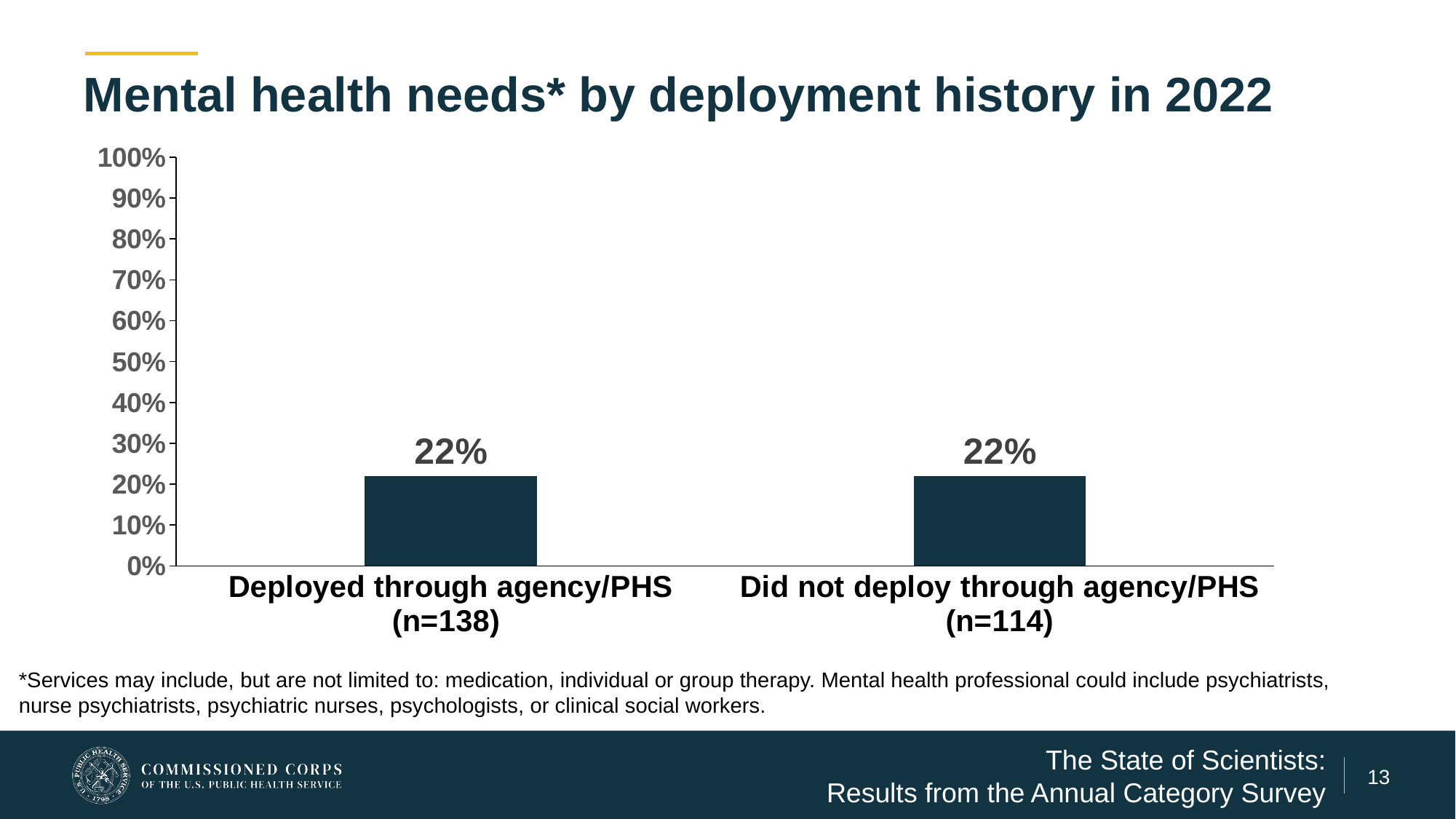
What is the value for Deployed through agency/PHS (n=138)? 22% What is the value for Did not deploy through agency/PHS (n=114)? 22% What is the maximum value shown on the y axis? 100% What is the sample size (n) for the Did not deploy through agency/PHS category? 114 What is the sample size (n) for the Deployed through agency/PHS category? 138 What is the difference between the values for Deployed through agency/PHS and Did not deploy through agency/PHS? 0% Is the value for Deployed through agency/PHS (n=138) greater or less than 50%? less Is the value for Did not deploy through agency/PHS (n=114) greater or less than 30%? less How many categories are shown on the x axis? 2 What is the title of the chart? Mental health needs* by deployment history in 2022 What kind of chart is shown on the slide? Bar chart